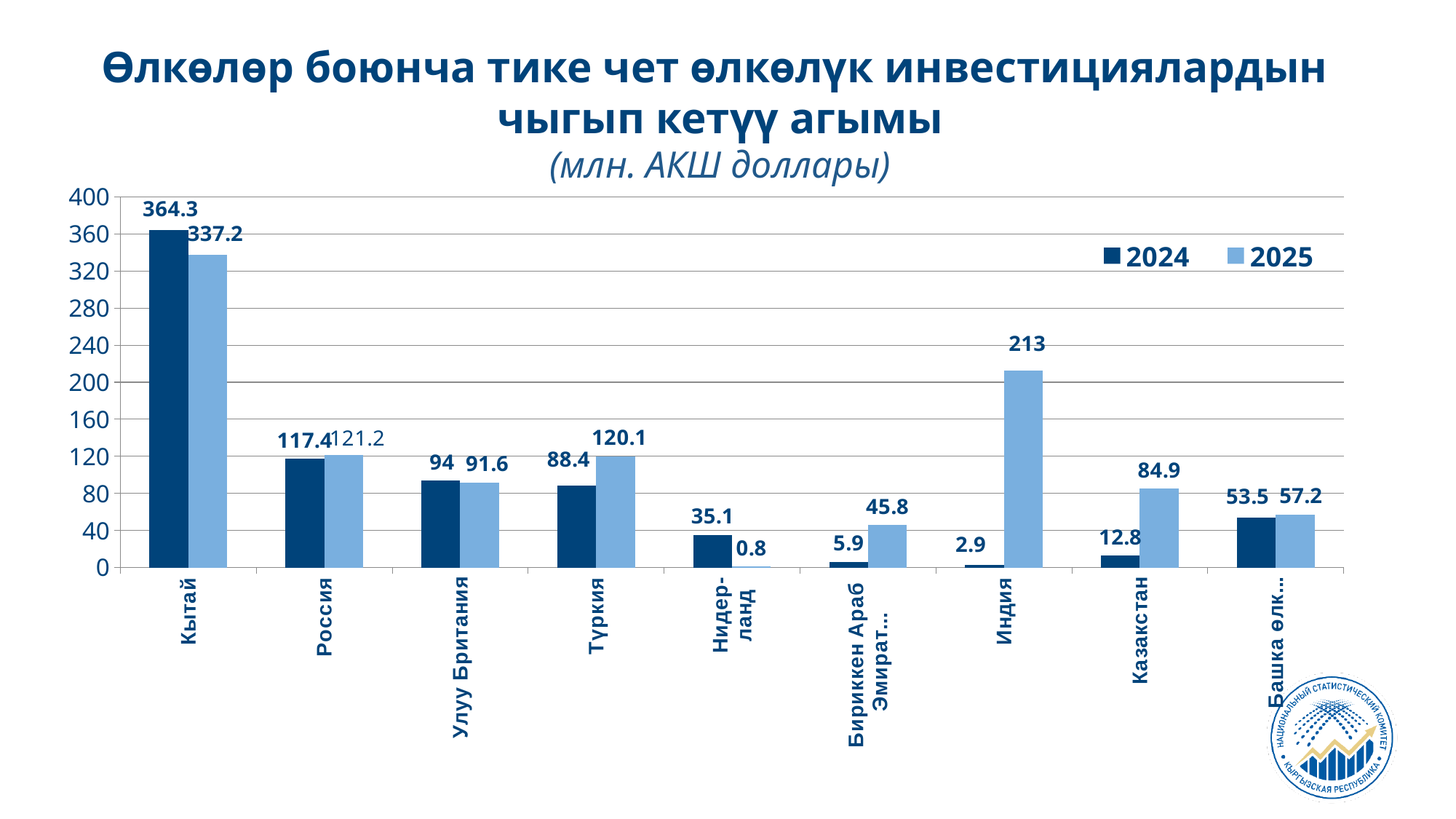
What is the 2024 value for Кытай? 364.3 How many series does the legend list? 2 What is the difference between the 2024 and 2025 values for Кытай? 27.1 Which is larger for Россия: the 2024 value or the 2025 value? 2025 Is the 2025 value for Индия greater or less than 200? greater What is the 2024 value for Түркия? 88.4 Which country has the lowest 2025 value? Нидерланд What is the 2025 value for Казакстан? 84.9 What is the 2025 value for Индия? 213 What kind of chart is shown on the slide? Bar chart Which country has the highest 2024 value? Кытай How many countries/categories are shown on the x axis? 9